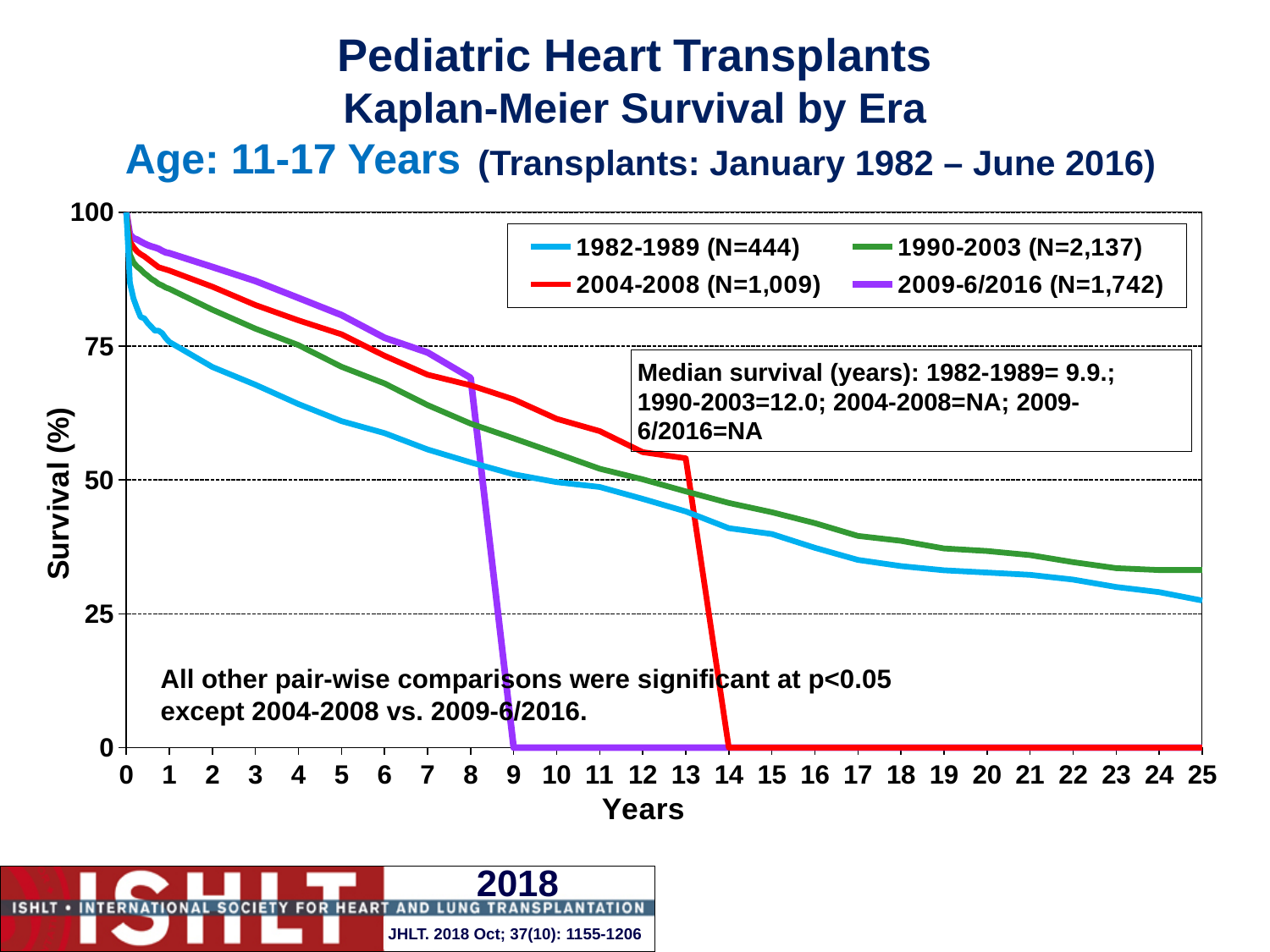
What is the median survival in years for the 1982-1989 era, as stated on the slide? 9.9 What is the N for the 2009-6/2016 era shown in the legend? 1,742 Is the survival value for the 2009-6/2016 era at 5 years greater or less than 75? greater Do the survival curves rise or fall as years increase along the x axis? Fall Is the survival value for the 1982-1989 era at 20 years greater or less than 25? greater What kind of chart is shown on the slide? Line chart How many series does the legend list? 4 Is the survival value for the 1990-2003 era at 15 years greater or less than 50? less What is the median survival for the 2004-2008 era, as stated on the slide? NA What is the N for the 1990-2003 era shown in the legend? 2,137 At 5 years, which era has higher survival: 2009-6/2016 or 1982-1989? 2009-6/2016 What is the median survival in years for the 1990-2003 era, as stated on the slide? 12.0